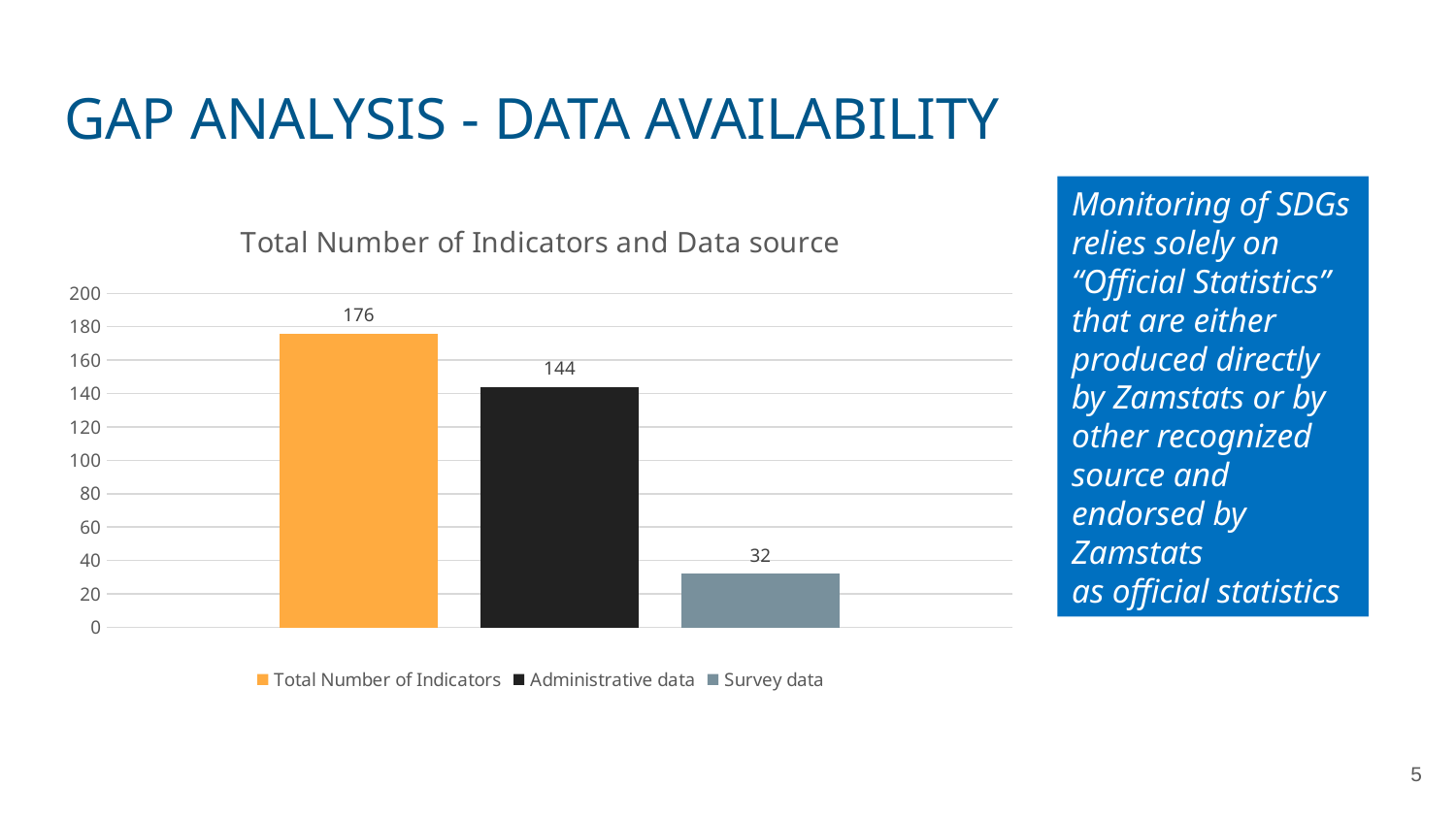
Which series has the lowest value? Survey data What is the value for Administrative data? 144 Which series has the highest value? Total Number of Indicators What is the difference between Administrative data and Survey data? 112 Which is larger, Administrative data or Survey data? Administrative data What is the value for Total Number of Indicators? 176 What is the difference between Total Number of Indicators and Administrative data? 32 What is the title of the chart? Total Number of Indicators and Data source What kind of chart is shown on the slide? bar chart How many series does the legend list? 3 Is the value for Survey data greater or less than 40? less What is the value for Survey data? 32